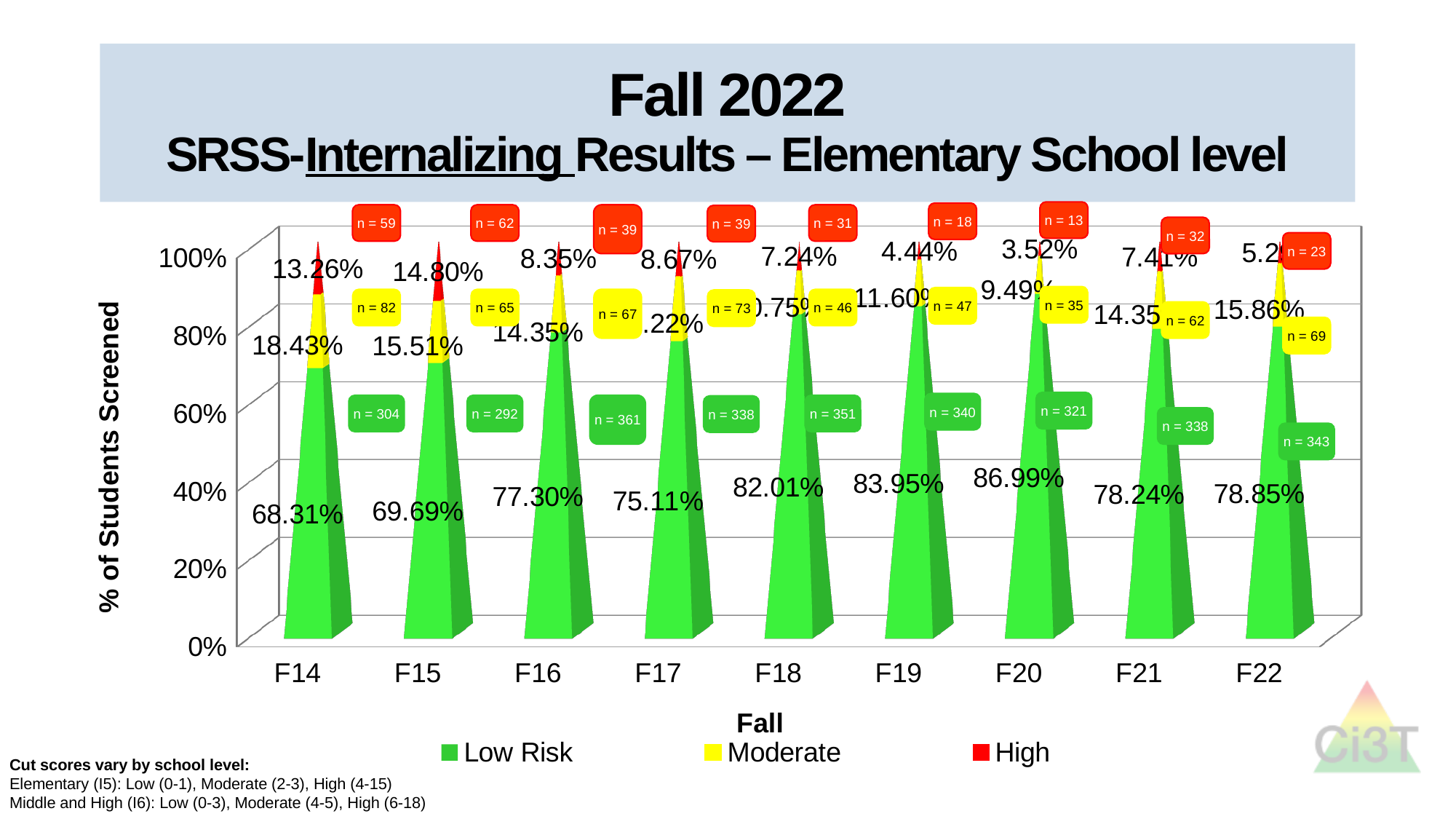
How many fall semesters are shown on the x axis? 9 What is the difference between the Low Risk percentages for F22 and F21? 0.61% How many series does the legend list? 3 What is the n value shown for the Low Risk group in F16? n = 361 Which fall has the lowest Low Risk percentage? F14 Which fall has the lowest High percentage? F20 Which fall has the highest Low Risk percentage? F20 Which is larger, the Moderate percentage for F14 or for F15? F14 What is the Moderate percentage for F22? 15.86% What is the Low Risk percentage for F20? 86.99% What is the High percentage for F15? 14.80% What kind of chart is shown on the slide? Stacked bar chart